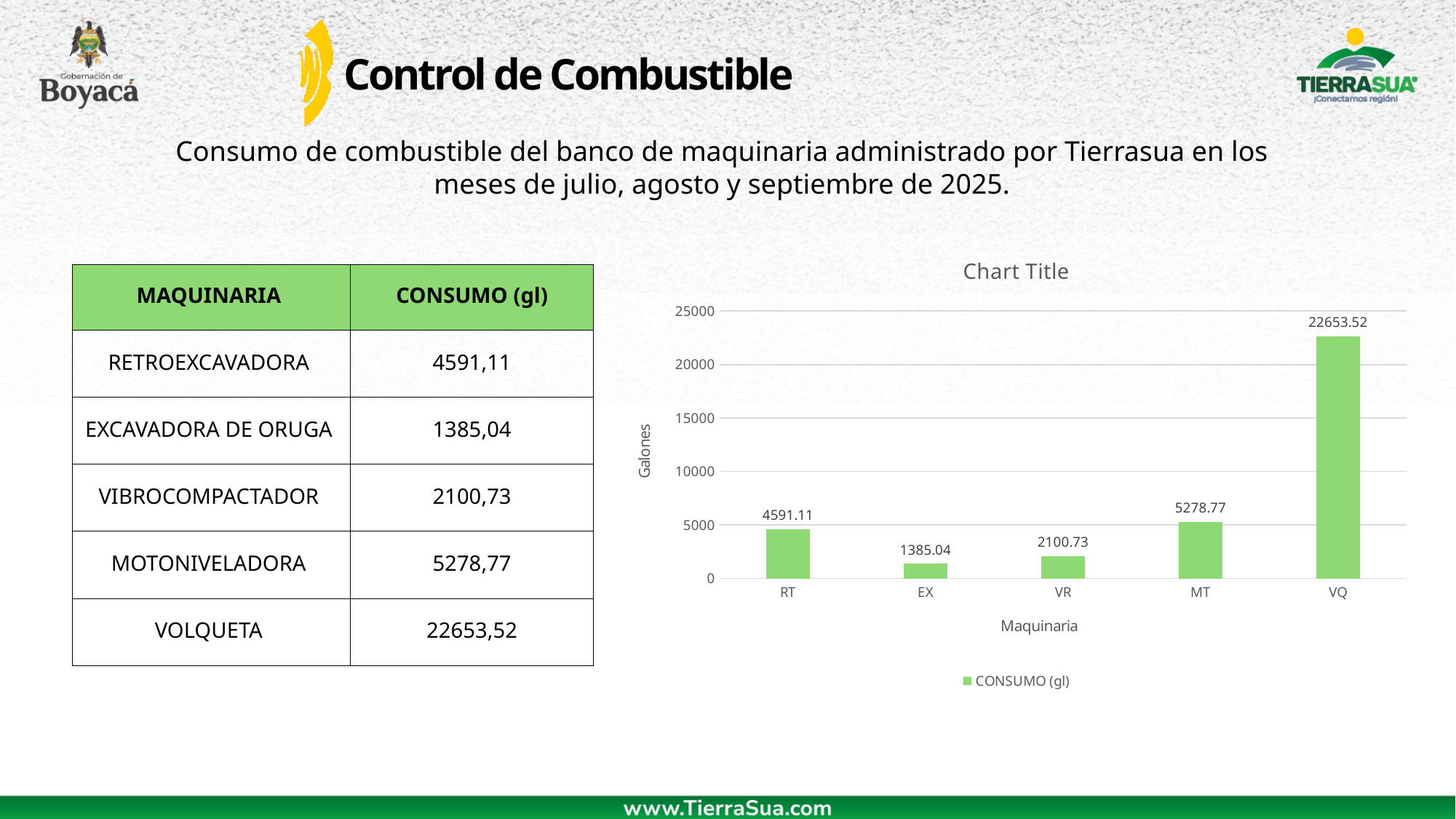
What is the value for RT? 4591.11 How many categories are shown on the x axis? 5 Which is larger, the value for MT or the value for RT? MT What is the value for EX? 1385.04 What is the difference between the values for MT and VR? 3178.04 What series name does the legend show? CONSUMO (gl) Is the value for VQ greater or less than 20000? greater Which category has the highest value? VQ What is the difference between the values for VQ and RT? 18062.41 What is the value for VQ? 22653.52 Which category has the lowest value? EX What kind of chart is shown? bar chart